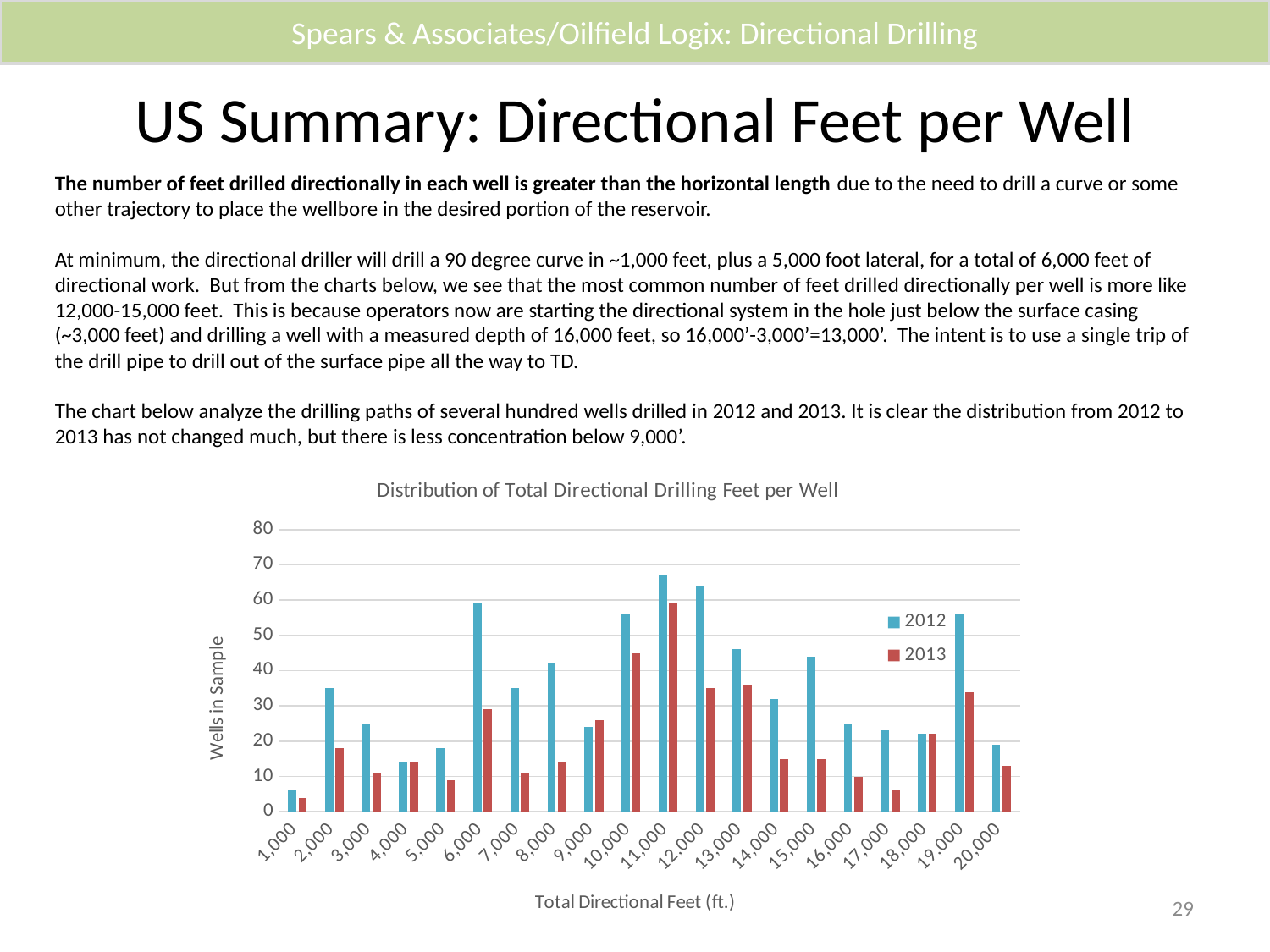
Which category has the highest value for the 2012 series? 11,000 Is the 2013 value for 17,000 greater or less than 10? less Which category has the highest value for the 2013 series? 11,000 What is the label of the y axis? Wells in Sample Is the 2012 value for 6,000 greater or less than 50? greater Is the 2013 value for 10,000 greater or less than 40? greater How many series does the chart legend list? 2 For the 19,000 category, which series has the larger value, 2012 or 2013? 2012 What type of chart is shown on the slide? bar chart How many categories are shown along the x axis of the chart? 20 Which category has the lowest value for the 2012 series? 1,000 What is the title of the chart? Distribution of Total Directional Drilling Feet per Well